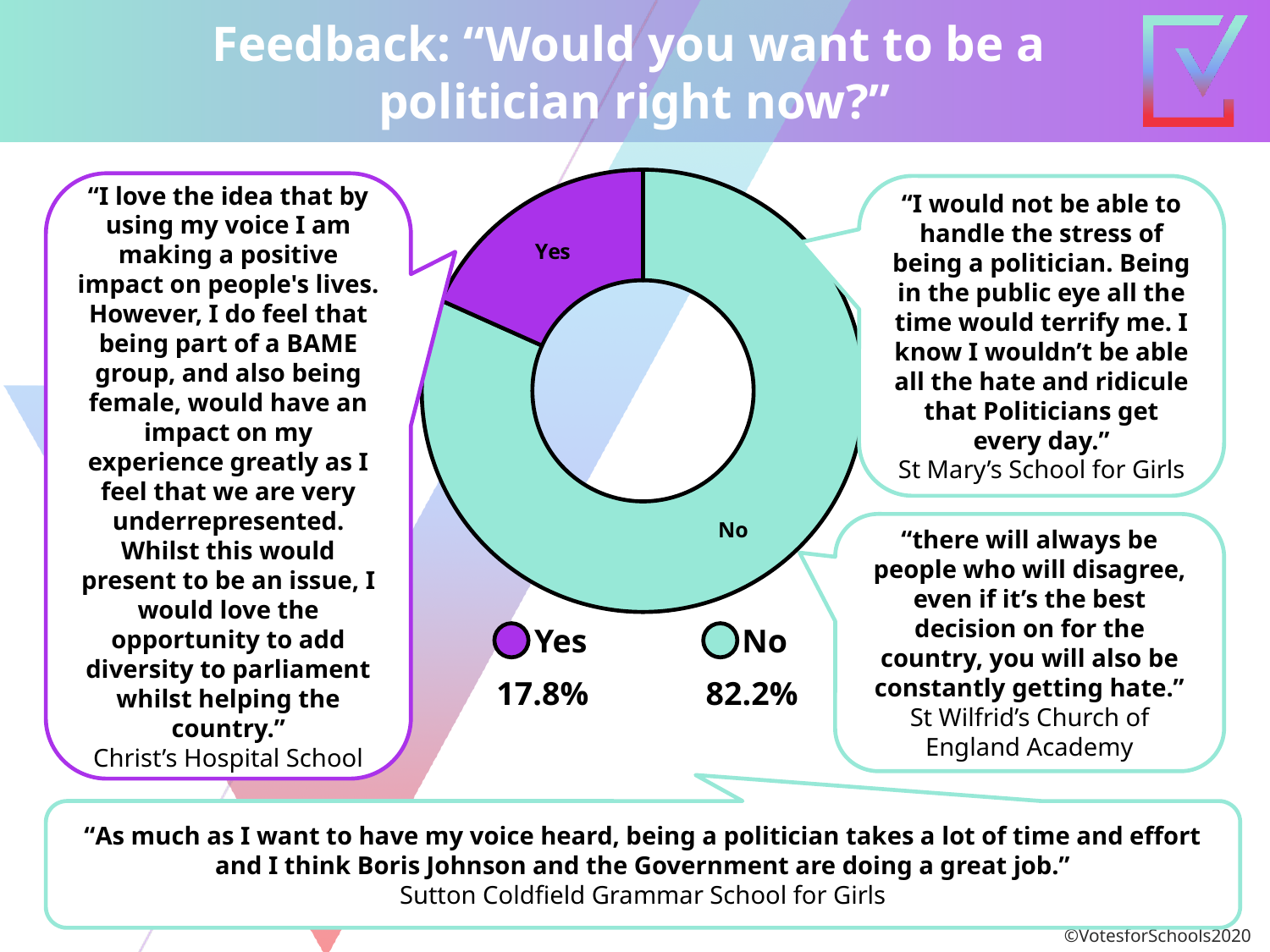
Which response has the smallest share of the chart? Yes What question does the chart's feedback relate to, according to the slide title? Would you want to be a politician right now? What colour is the Yes segment of the chart? Purple Which is larger, the share for Yes or the share for No? No What percentage of respondents answered Yes? 17.8% What is the total of the Yes and No percentages? 100% What percentage of respondents answered No? 82.2% What is the difference in percentage points between the No and Yes responses? 64.4 What kind of chart is shown on the slide? Doughnut chart Which response has the largest share of the chart? No How many categories does the chart show? 2